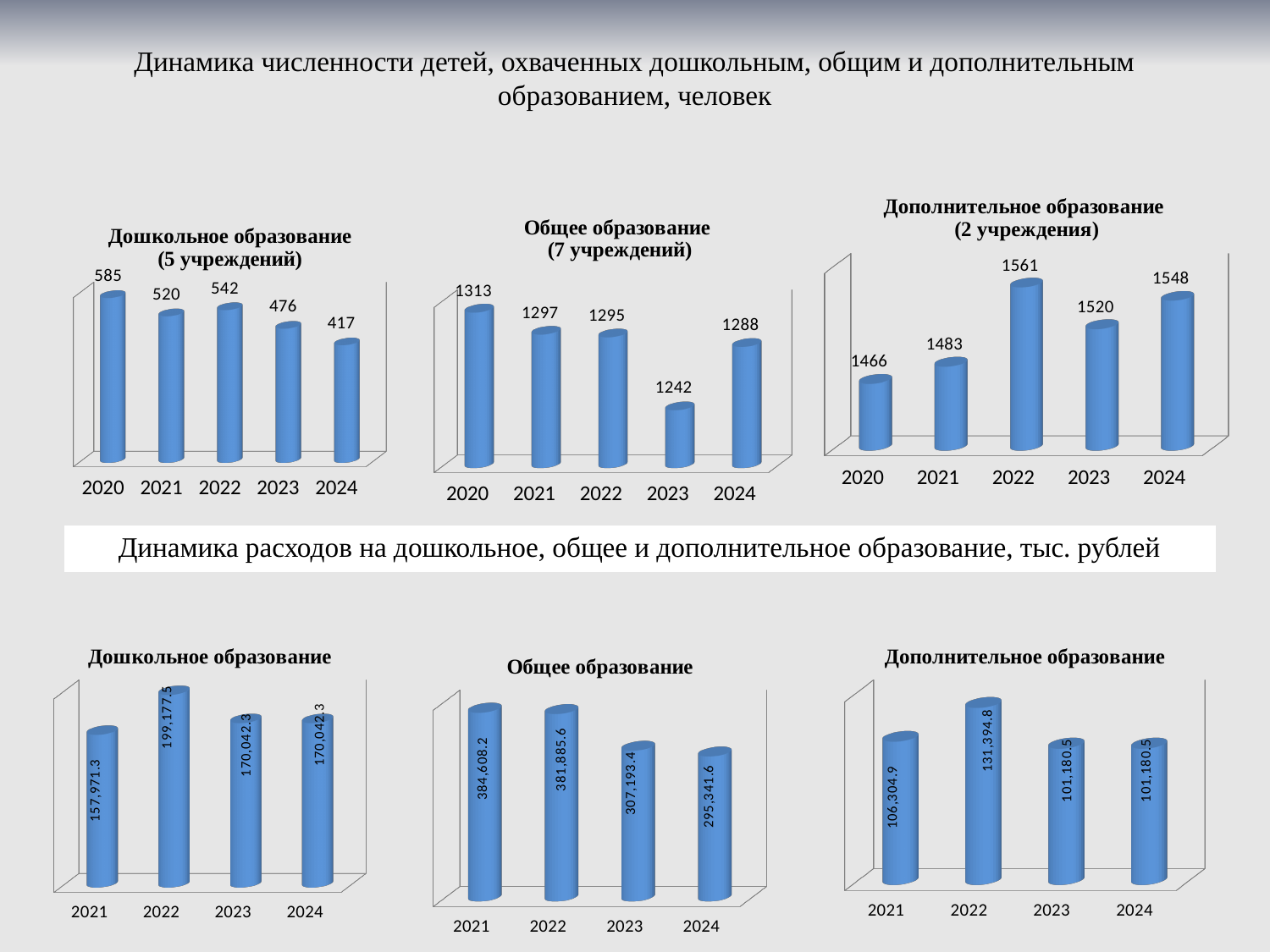
In the bottom-middle chart 'Общее образование' (expenditures), do the values rise or fall from 2021 to 2024? fall What type of chart is the bottom-right chart 'Дополнительное образование' (expenditures)? bar chart In the top-middle chart 'Общее образование (7 учреждений)', what is the difference between the values for 2020 and 2023? 71 In the bottom-middle chart 'Общее образование' (expenditures), what is the value for 2024? 295,341.6 How many years are shown on the x axis of the top-left chart 'Дошкольное образование (5 учреждений)'? 5 In the bottom-right chart 'Дополнительное образование' (expenditures), which year has the highest value? 2022 In the top-middle chart 'Общее образование (7 учреждений)', which year has the lowest value? 2023 In the top-right chart 'Дополнительное образование (2 учреждения)', what is the value for 2022? 1561 In the top-left chart 'Дошкольное образование (5 учреждений)', which year has the highest value? 2020 In the top-left chart 'Дошкольное образование (5 учреждений)', what is the value for 2024? 417 In the top-right chart 'Дополнительное образование (2 учреждения)', which is larger: the value for 2021 or the value for 2023? 2023 In the bottom-left chart 'Дошкольное образование' (expenditures), what is the value for 2022? 199,177.5